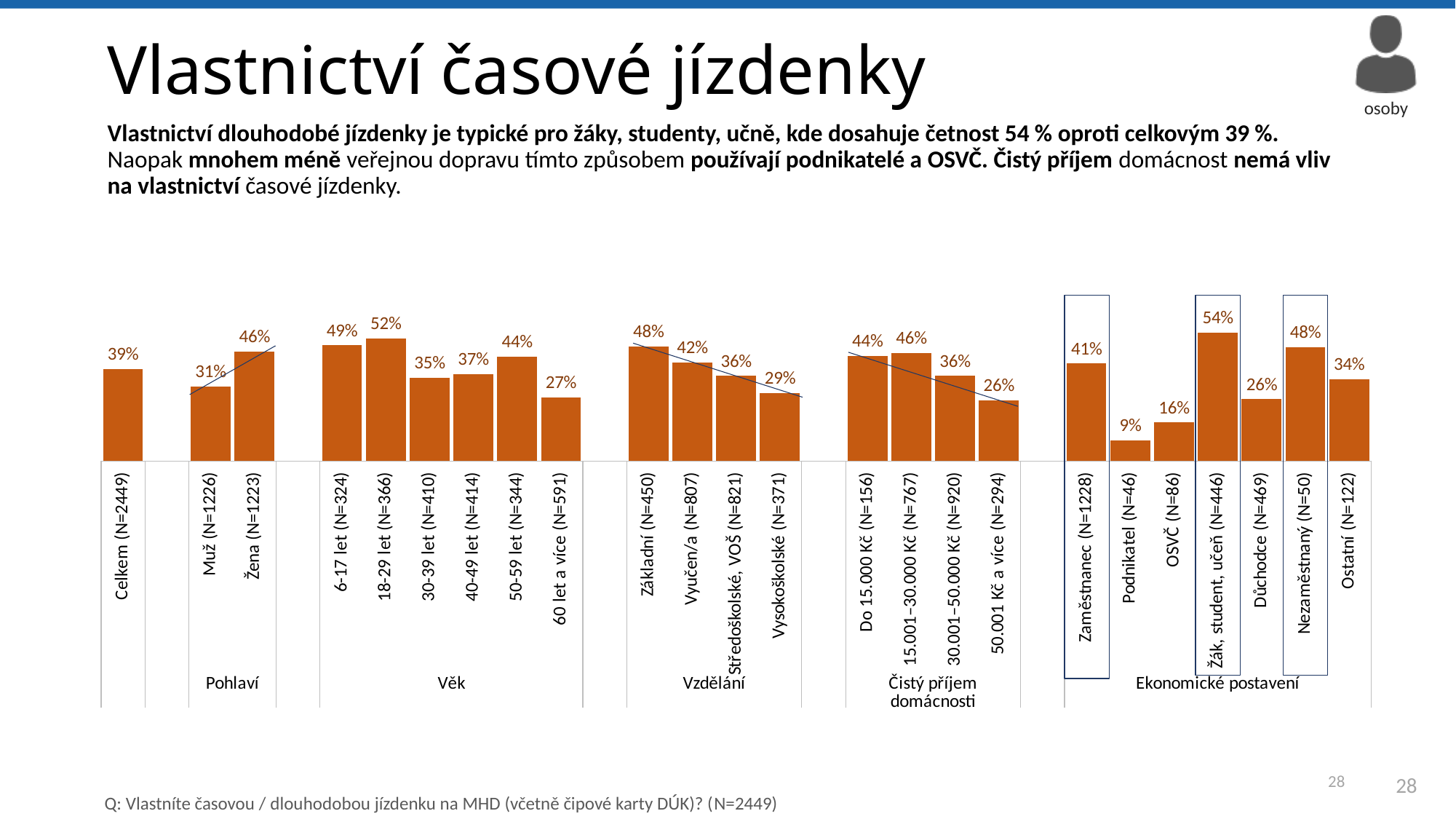
What is the value for Žák, student, učeň (N=446)? 54% What is the value for Podnikatel (N=46)? 9% What is the difference between the values for Žena (N=1223) and Muž (N=1226)? 15% Do the values rise or fall across the Čistý příjem domácnosti group from Do 15.000 Kč to 50.001 Kč a více? Fall What kind of chart is shown on the slide? Bar chart What is the value for Celkem (N=2449)? 39% How many bars are plotted in the chart? 24 Which is larger, the value for Základní (N=450) or Vysokoškolské (N=371)? Základní (N=450) What is the difference between the values for 6-17 let (N=324) and 60 let a více (N=591)? 22% Which category has the highest value in the chart? Žák, student, učeň (N=446) What is the value for 18-29 let (N=366)? 52% Which category has the lowest value in the chart? Podnikatel (N=46)